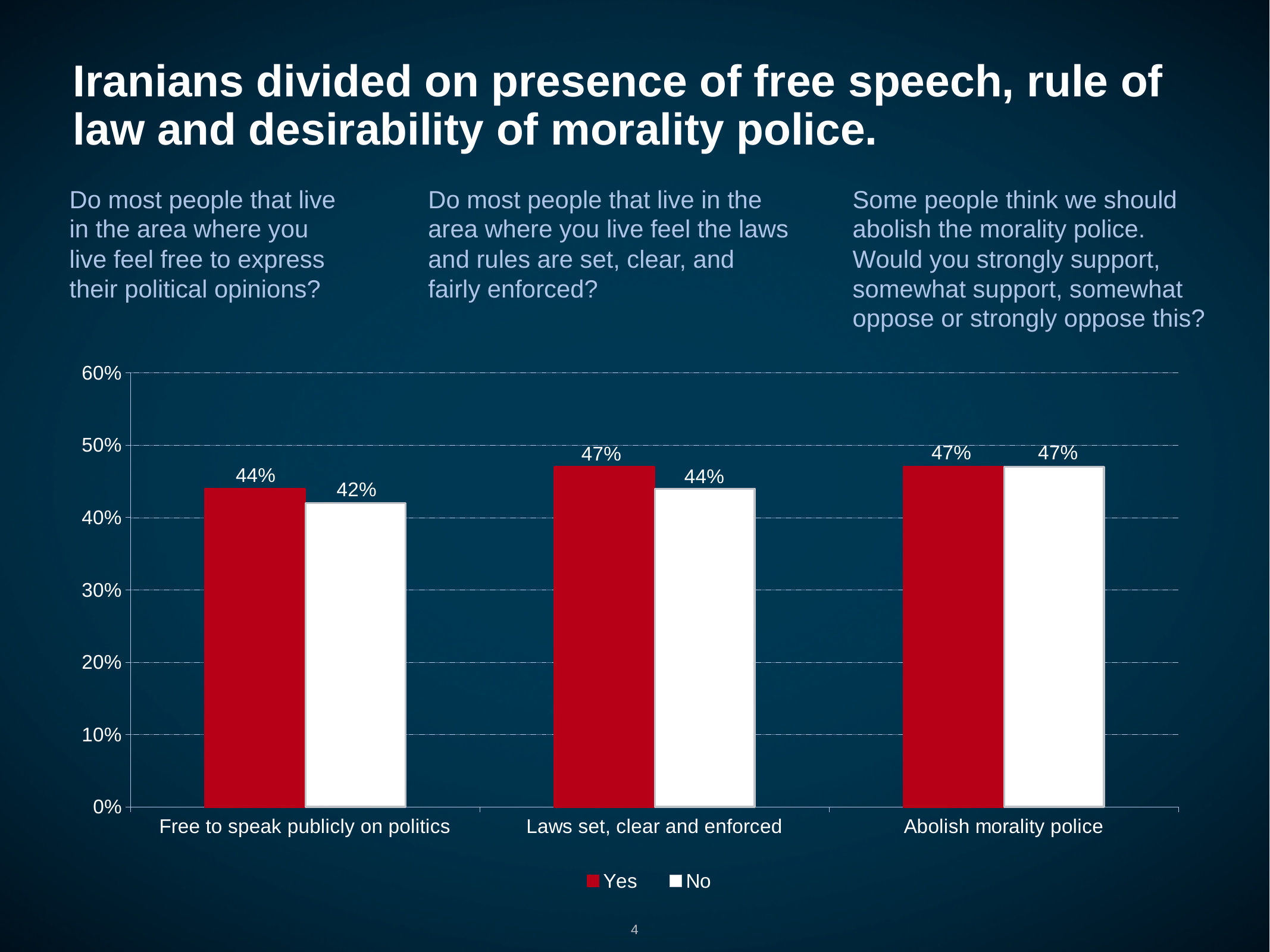
How many series does the legend list? 2 Is the No value for "Abolish morality police" greater or less than 40%? greater What is the No value for "Free to speak publicly on politics"? 42% What kind of chart is shown on the slide? Bar chart Which category has the lowest No value? Free to speak publicly on politics What is the difference between the Yes and No values for "Free to speak publicly on politics"? 2% What is the Yes value for "Free to speak publicly on politics"? 44% How many categories are shown on the x axis? 3 Which is larger for "Laws set, clear and enforced": the Yes value or the No value? Yes What is the difference between the Yes and No values for "Laws set, clear and enforced"? 3% What is the Yes value for "Abolish morality police"? 47% What is the No value for "Laws set, clear and enforced"? 44%